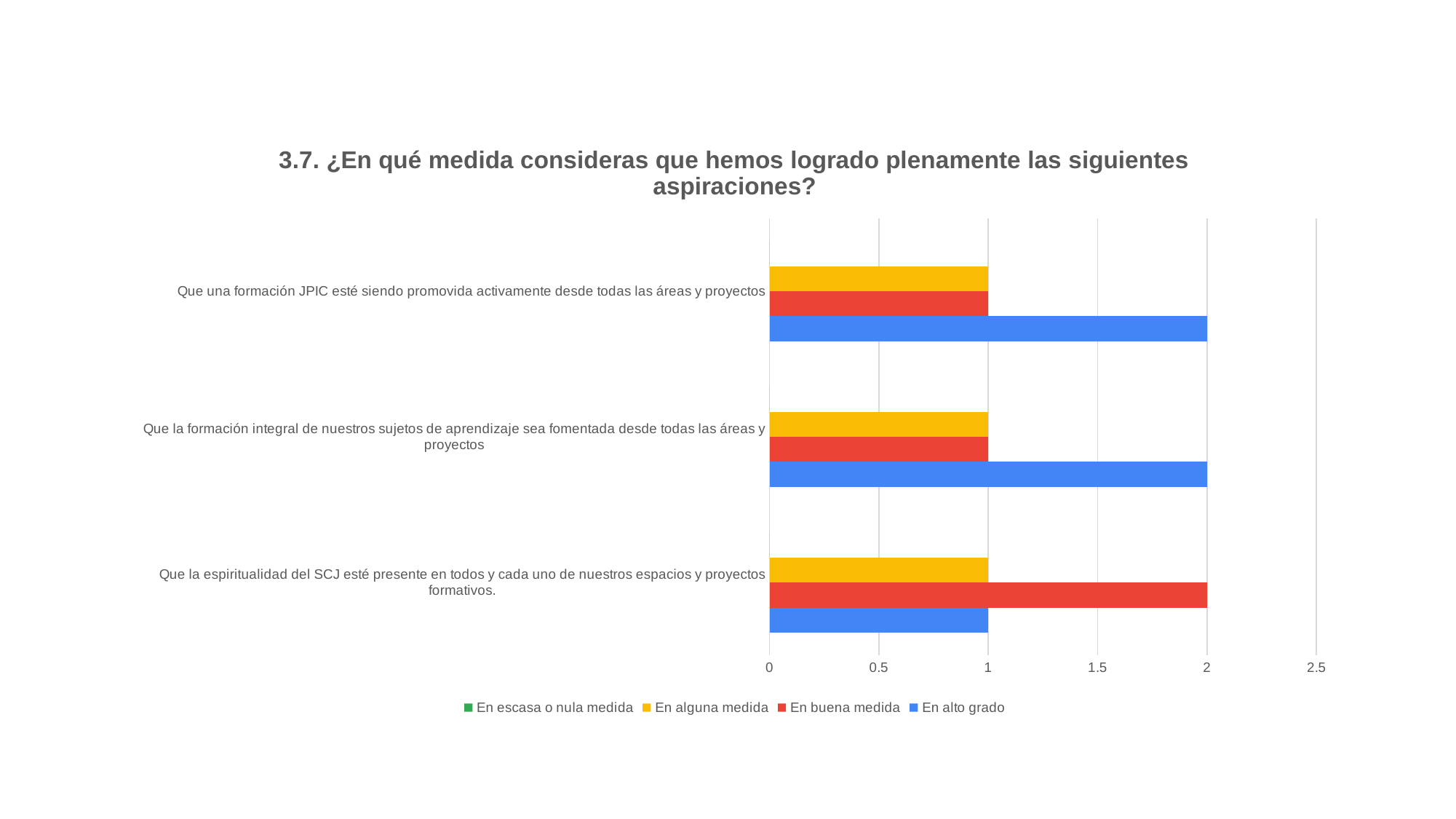
What is the value of "En alguna medida" for "Que la formación integral de nuestros sujetos de aprendizaje sea fomentada desde todas las áreas y proyectos"? 1 Which series has the highest value for "Que una formación JPIC esté siendo promovida activamente desde todas las áreas y proyectos"? En alto grado What kind of chart is shown on the slide? Bar chart How many series does the legend list? 4 Which series has the highest value for "Que la espiritualidad del SCJ esté presente en todos y cada uno de nuestros espacios y proyectos formativos."? En buena medida What is the difference between "En alto grado" and "En buena medida" for "Que la formación integral de nuestros sujetos de aprendizaje sea fomentada desde todas las áreas y proyectos"? 1 How many categories (aspirations) are plotted on the chart? 3 Which legend series has no visible bars on the chart? En escasa o nula medida What is the value of "En buena medida" for "Que la espiritualidad del SCJ esté presente en todos y cada uno de nuestros espacios y proyectos formativos."? 2 For "Que la espiritualidad del SCJ esté presente en todos y cada uno de nuestros espacios y proyectos formativos.", which is larger: "En buena medida" or "En alto grado"? En buena medida What is the value of "En alto grado" for "Que una formación JPIC esté siendo promovida activamente desde todas las áreas y proyectos"? 2 What is the value of "En alto grado" for "Que la espiritualidad del SCJ esté presente en todos y cada uno de nuestros espacios y proyectos formativos."? 1